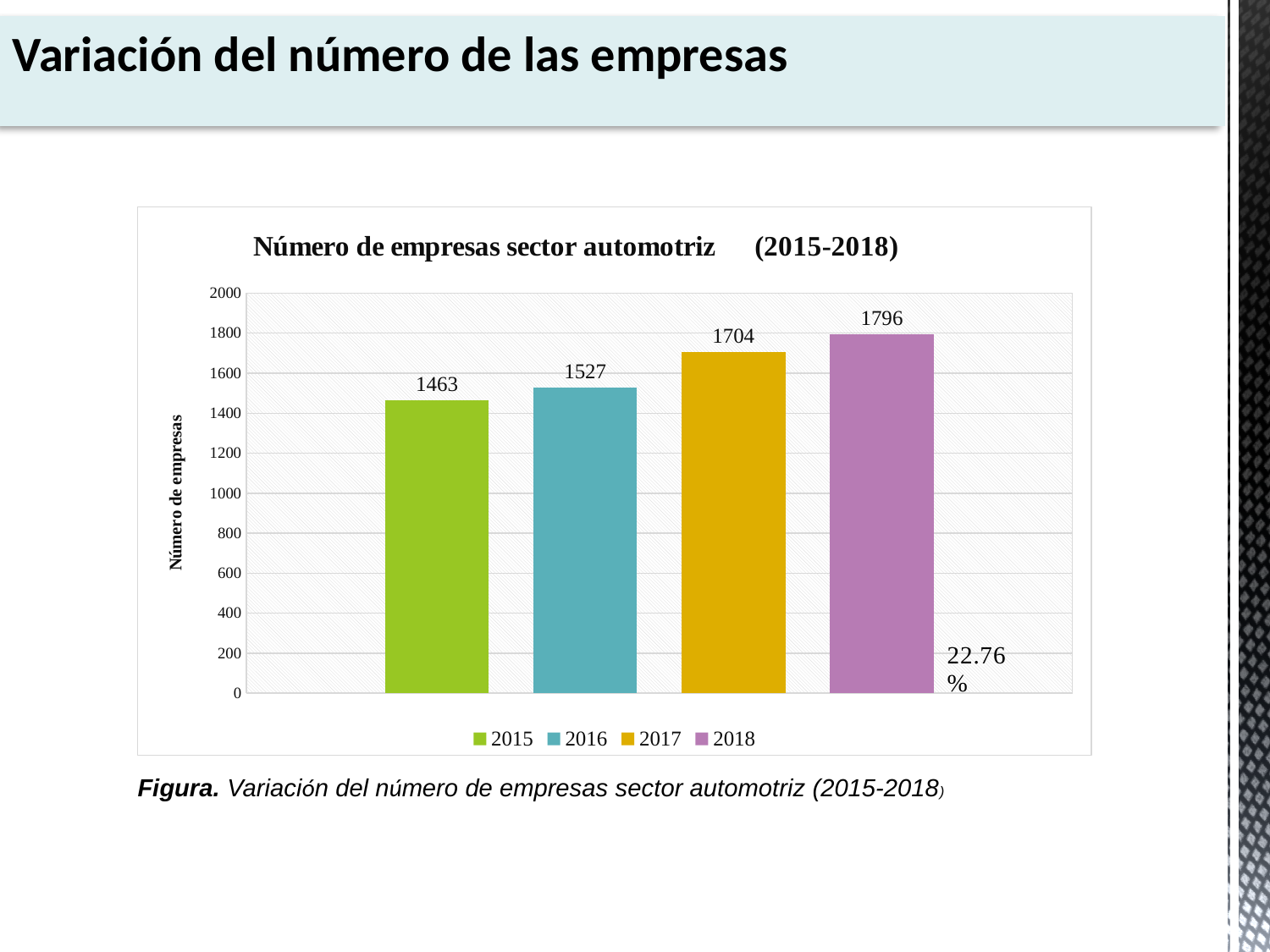
What is the difference between the number of companies in 2018 and in 2015? 333 How many years are shown in the chart? 4 What is the title of the chart? Número de empresas sector automotriz (2015-2018) What is the number of companies in 2015? 1463 Do the values rise or fall from 2015 to 2018? Rise What is the difference between the number of companies in 2017 and in 2016? 177 What is the number of companies in 2017? 1704 Which year has the highest number of companies? 2018 What is the number of companies in 2018? 1796 What kind of chart is shown on the slide? Bar chart Which year has the lowest number of companies? 2015 Which is larger, the value for 2016 or the value for 2017? 2017